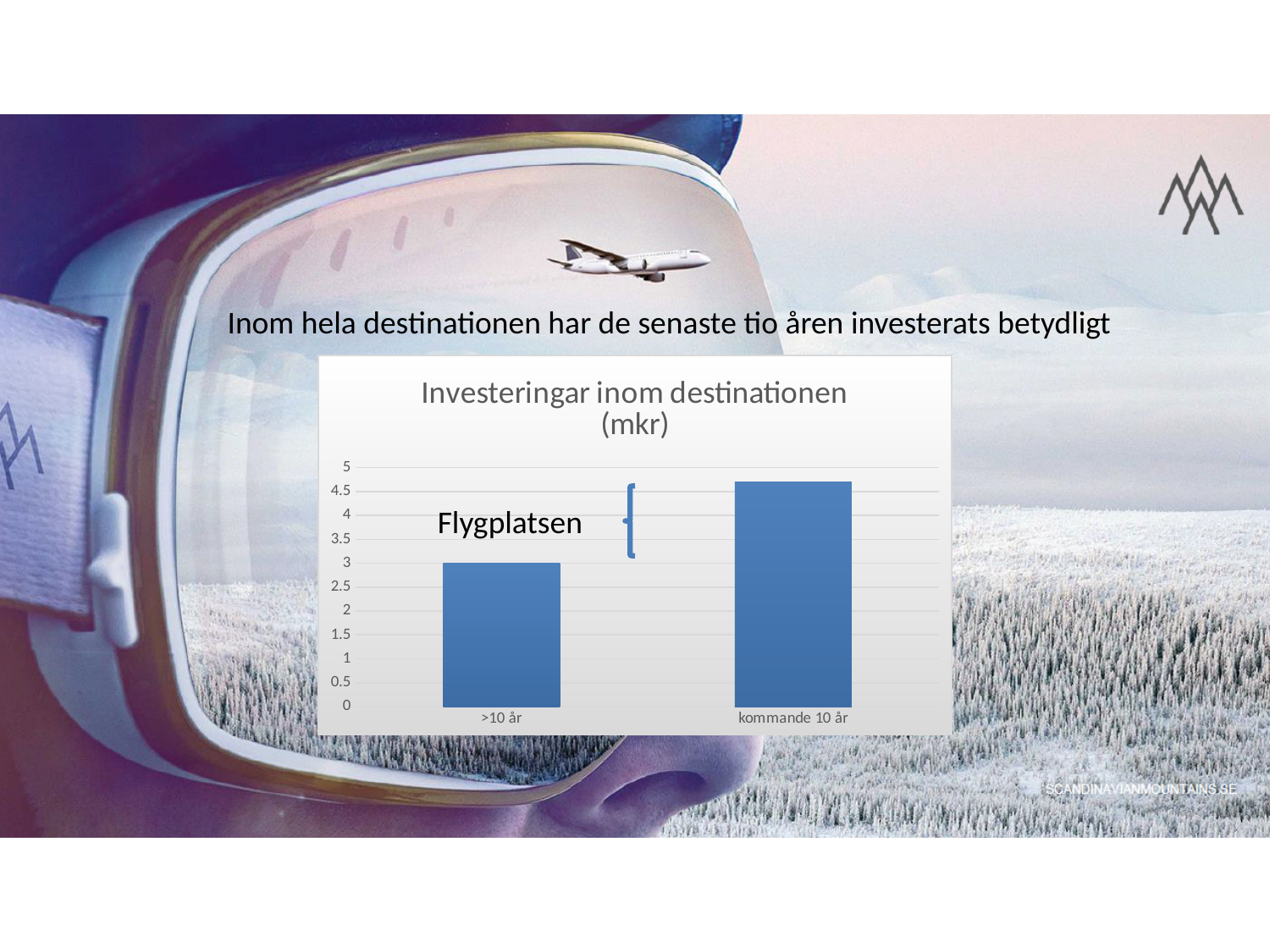
What is the title of the chart? Investeringar inom destinationen (mkr) How many categories are shown on the x axis of the chart? 2 Which is larger: the value for ">10 år" or the value for "kommande 10 år"? kommande 10 år What kind of chart is shown on the slide? bar chart What is the value for ">10 år" in the chart? 3 Which category has the lowest value in the chart? >10 år What is the maximum value shown on the vertical axis of the chart? 5 Which category has the highest value in the chart? kommande 10 år Do the values rise or fall from ">10 år" to "kommande 10 år"? rise Is the value for ">10 år" greater or less than 3.5? less Is the value for "kommande 10 år" greater or less than 4.5? greater Is the value for "kommande 10 år" greater or less than 4? greater